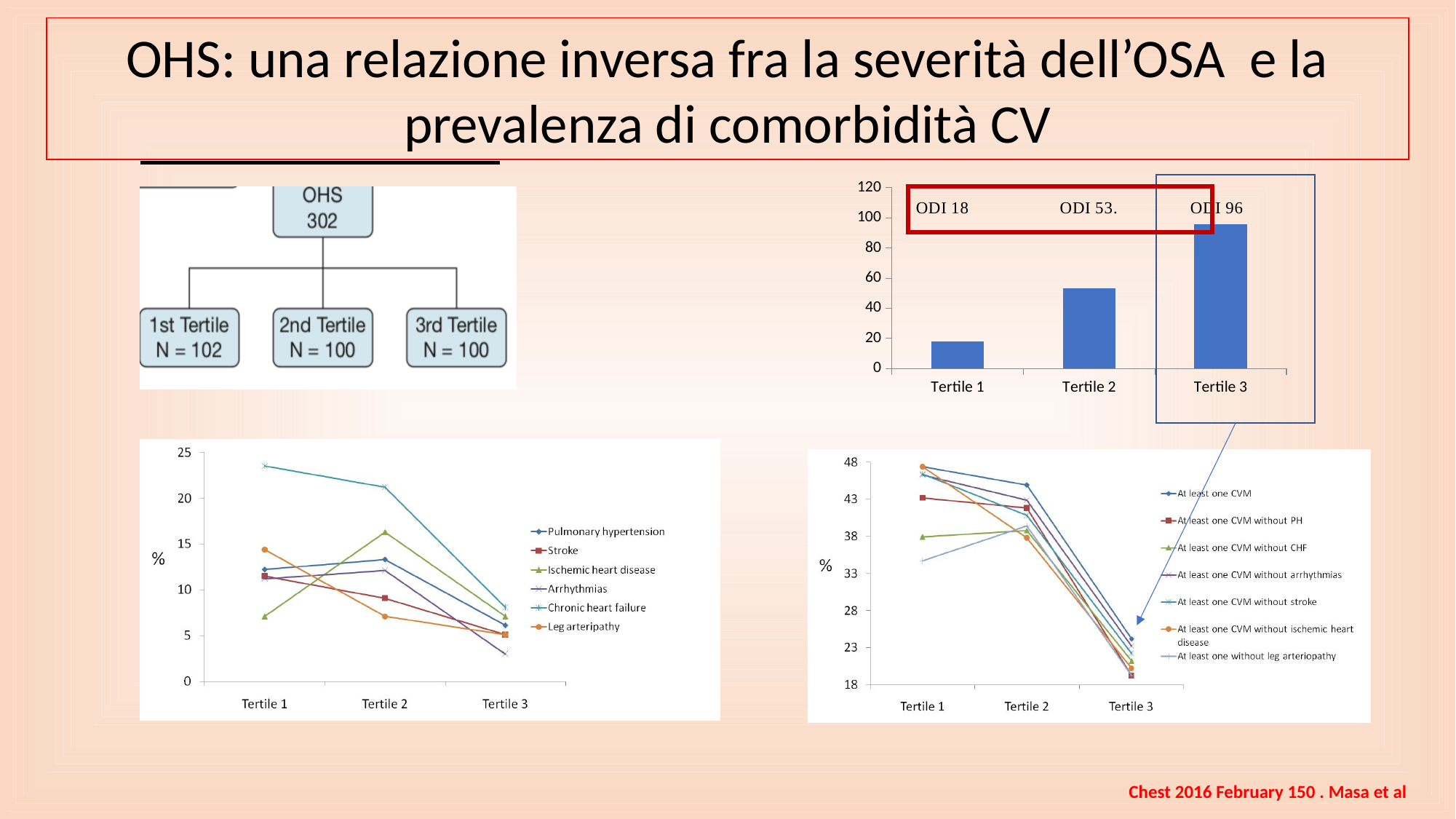
In the bottom-left line chart, which series has the highest value at Tertile 1? Chronic heart failure In the top-right bar chart, which tertile has the lowest bar? Tertile 1 In the top-right bar chart, what is the difference between the ODI values for Tertile 3 and Tertile 1? 78 How many series does the legend of the bottom-right line chart list? 7 In the bottom-right line chart, do the values for 'At least one CVM' rise or fall from Tertile 1 to Tertile 3? fall In the top-right bar chart, what ODI value is shown for Tertile 3? 96 In the top-right bar chart, is the value for Tertile 2 greater or less than 40? greater What kind of chart is the top-right chart with Tertile 1, Tertile 2 and Tertile 3? bar chart How many series does the legend of the bottom-left line chart list? 6 In the top-right bar chart, what ODI value is shown for Tertile 1? 18 In the bottom-left line chart, is the value for Chronic heart failure at Tertile 1 greater or less than 20? greater In the top-right bar chart, which tertile has the highest bar? Tertile 3